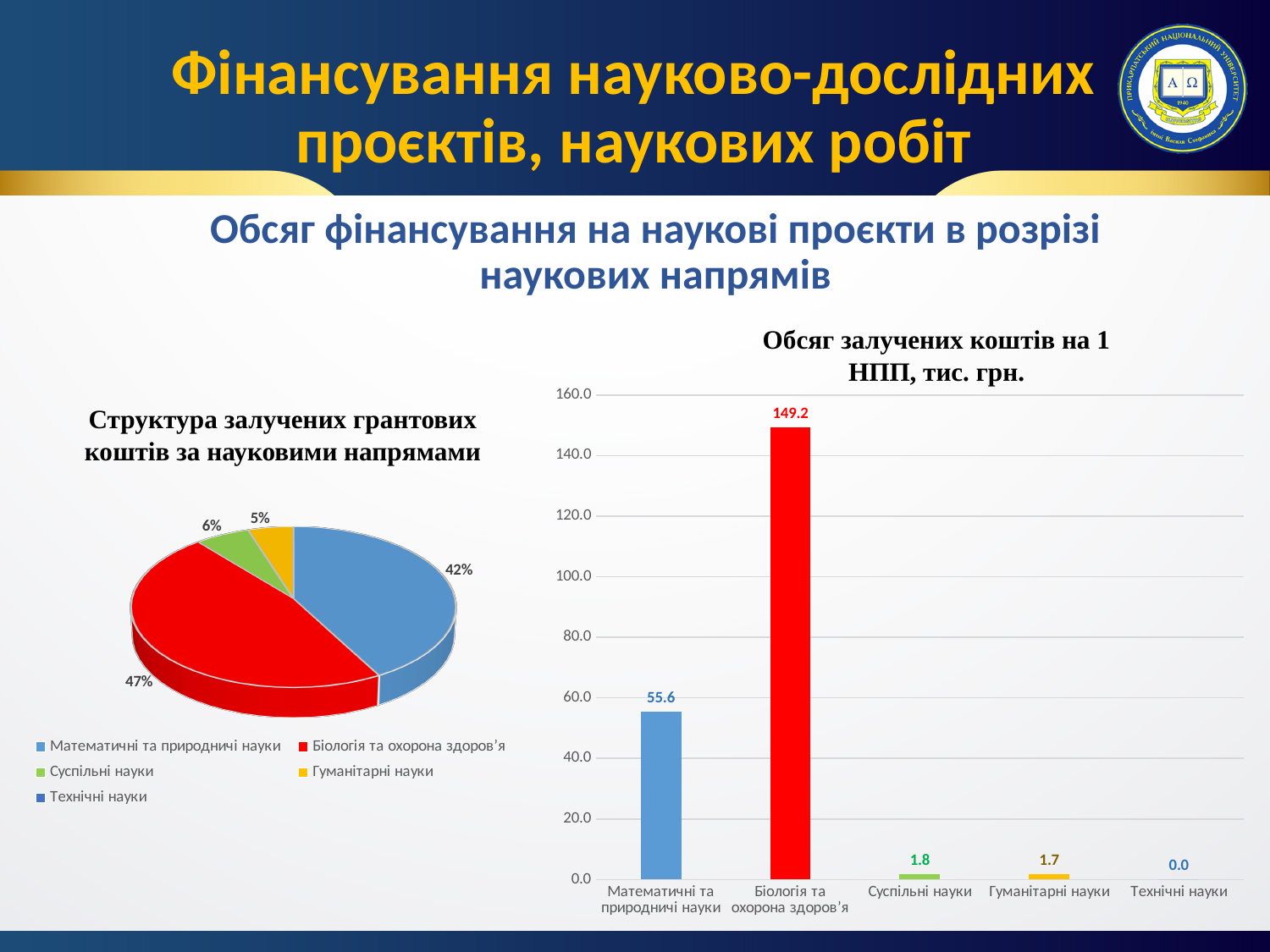
In the bar chart 'Обсяг залучених коштів на 1 НПП, тис. грн.', which is larger: Суспільні науки or Гуманітарні науки? Суспільні науки How many categories are shown in the bar chart 'Обсяг залучених коштів на 1 НПП, тис. грн.'? 5 In the pie chart 'Структура залучених грантових коштів за науковими напрямами', what share does Біологія та охорона здоров’я have? 47% In the bar chart 'Обсяг залучених коштів на 1 НПП, тис. грн.', which category has the highest value? Біологія та охорона здоров’я In the bar chart 'Обсяг залучених коштів на 1 НПП, тис. грн.', what is the value for Технічні науки? 0.0 In the pie chart 'Структура залучених грантових коштів за науковими напрямами', what share does Гуманітарні науки have? 5% In the bar chart 'Обсяг залучених коштів на 1 НПП, тис. грн.', what is the value for Біологія та охорона здоров’я? 149.2 What kind of chart is 'Обсяг залучених коштів на 1 НПП, тис. грн.'? Bar chart How many entries does the legend of the pie chart 'Структура залучених грантових коштів за науковими напрямами' list? 5 In the bar chart 'Обсяг залучених коштів на 1 НПП, тис. грн.', which category has the lowest value? Технічні науки In the bar chart 'Обсяг залучених коштів на 1 НПП, тис. грн.', what is the difference between the values for Біологія та охорона здоров’я and Математичні та природничі науки? 93.6 In the bar chart 'Обсяг залучених коштів на 1 НПП, тис. грн.', what is the value for Математичні та природничі науки? 55.6